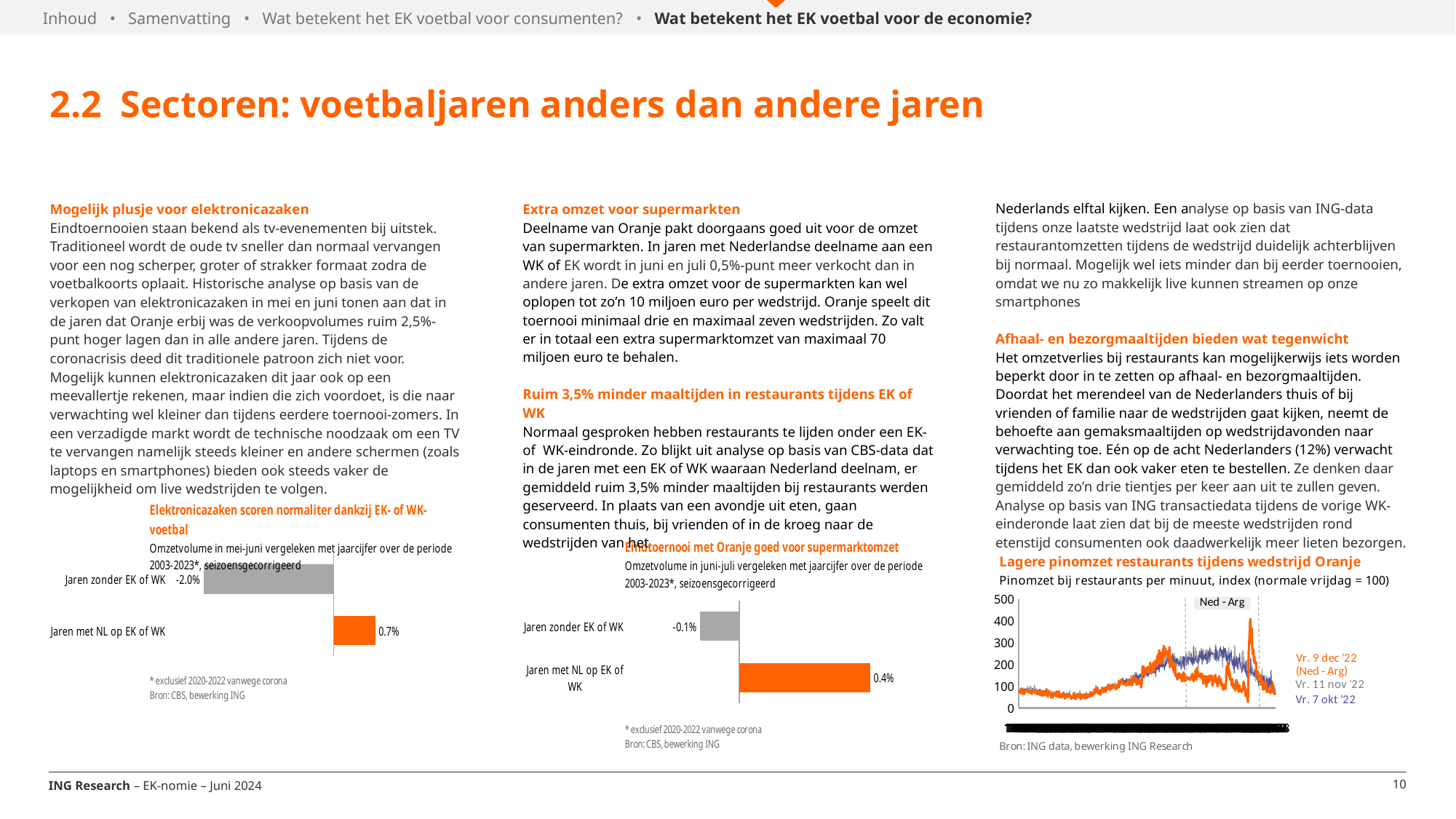
In the chart 'Eindtoernooi met Oranje goed voor supermarktomzet', what is the value for 'Jaren met NL op EK of WK'? 0.4% How many categories are shown in the chart 'Eindtoernooi met Oranje goed voor supermarktomzet'? 2 In the chart 'Eindtoernooi met Oranje goed voor supermarktomzet', what is the value for 'Jaren zonder EK of WK'? -0.1% In the chart 'Lagere pinomzet restaurants tijdens wedstrijd Oranje', which date is labelled as the Ned - Arg match? Vr. 9 dec '22 In the chart 'Eindtoernooi met Oranje goed voor supermarktomzet', which category has the higher value? Jaren met NL op EK of WK In the chart 'Elektronicazaken scoren normaliter dankzij EK- of WK-voetbal', what is the value for 'Jaren met NL op EK of WK'? 0.7% How many series are shown in the chart 'Lagere pinomzet restaurants tijdens wedstrijd Oranje'? 3 In the chart 'Eindtoernooi met Oranje goed voor supermarktomzet', what is the difference between the value for 'Jaren met NL op EK of WK' and the value for 'Jaren zonder EK of WK'? 0.5 percentage points In the chart 'Elektronicazaken scoren normaliter dankzij EK- of WK-voetbal', what is the difference between the value for 'Jaren met NL op EK of WK' and the value for 'Jaren zonder EK of WK'? 2.7 percentage points In the chart 'Elektronicazaken scoren normaliter dankzij EK- of WK-voetbal', what is the value for 'Jaren zonder EK of WK'? -2.0% What kind of chart is 'Lagere pinomzet restaurants tijdens wedstrijd Oranje'? Line chart What kind of chart is 'Elektronicazaken scoren normaliter dankzij EK- of WK-voetbal'? Bar chart